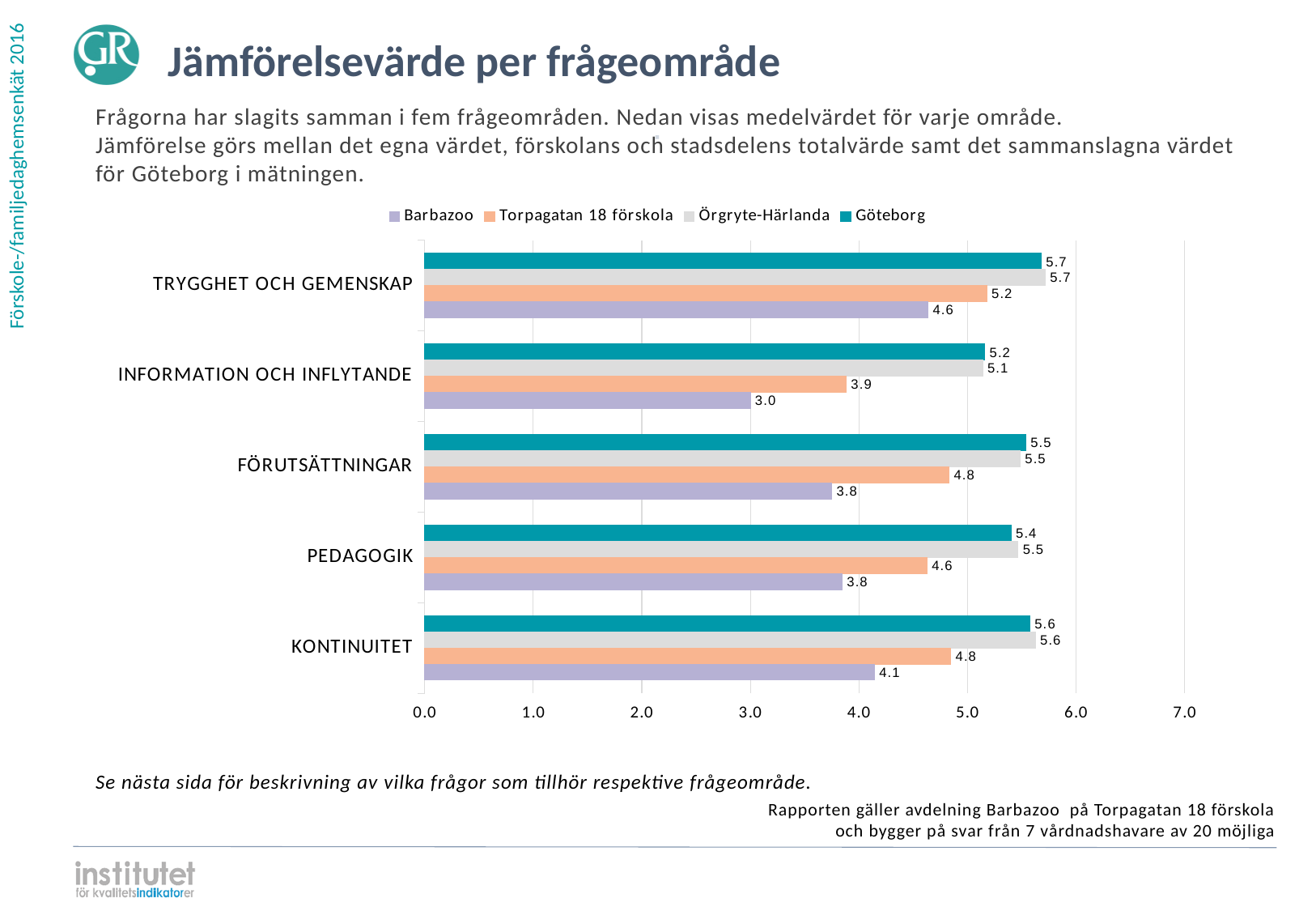
In which category does Barbazoo have its lowest value? INFORMATION OCH INFLYTANDE Which is larger in the PEDAGOGIK category: the value for Torpagatan 18 förskola or the value for Barbazoo? Torpagatan 18 förskola How many series does the legend list? 4 What kind of chart is shown on the slide? bar chart Is the value for Barbazoo in the KONTINUITET category greater or less than 5.0? less How many categories are shown on the chart? 5 What is the difference between the Göteborg value and the Barbazoo value in the FÖRUTSÄTTNINGAR category? 1.7 What is the value for Barbazoo in the INFORMATION OCH INFLYTANDE category? 3.0 What is the value for Torpagatan 18 förskola in the TRYGGHET OCH GEMENSKAP category? 5.2 In which category does Barbazoo have its highest value? TRYGGHET OCH GEMENSKAP What is the value for Göteborg in the PEDAGOGIK category? 5.4 What is the value for Örgryte-Härlanda in the KONTINUITET category? 5.6